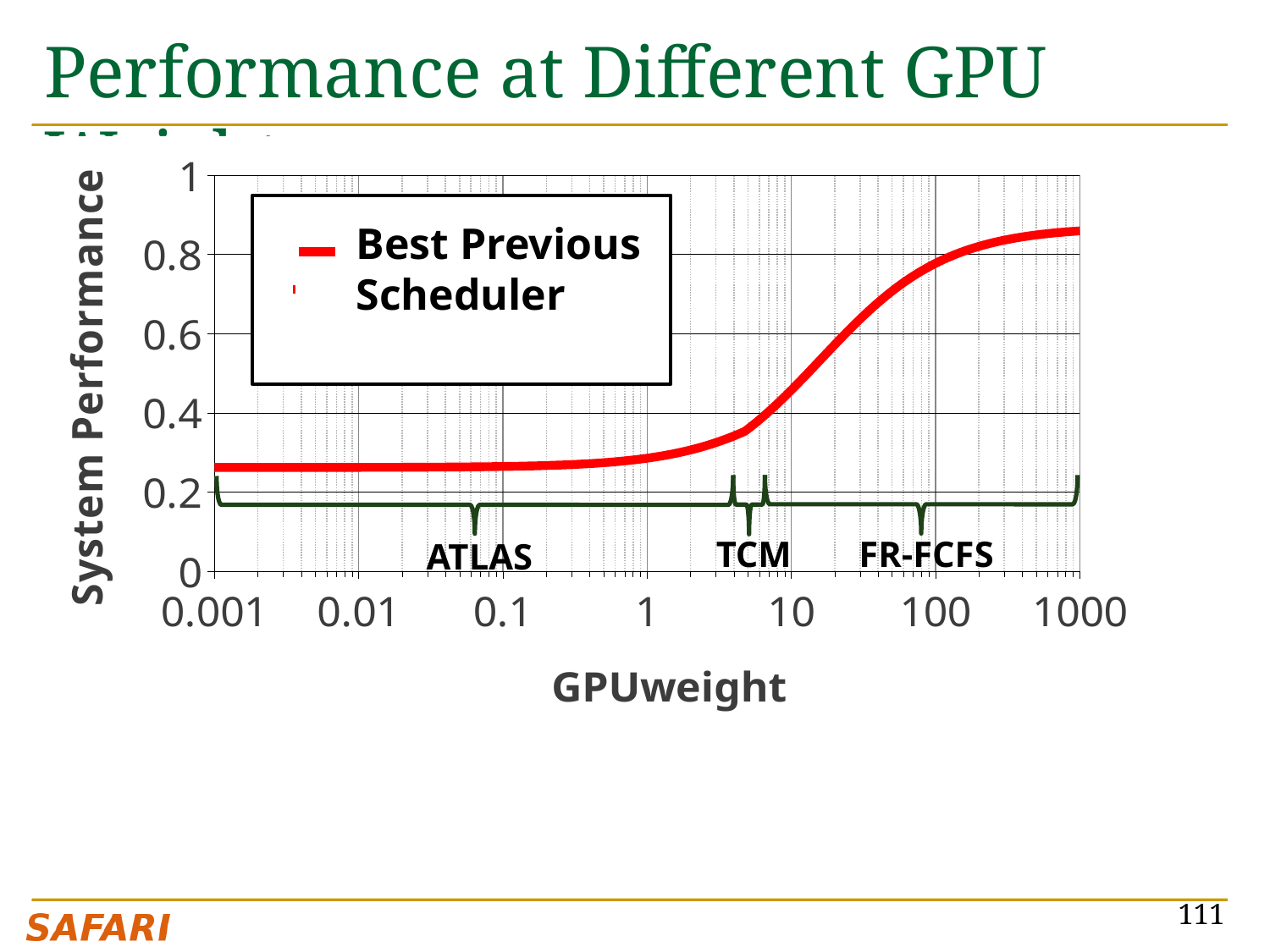
Is the System Performance of the Best Previous Scheduler at GPUweight 0.001 greater or less than 0.4? less What kind of chart is shown on the slide? line chart Is the System Performance of the Best Previous Scheduler at GPUweight 1 greater or less than 0.4? less Does the Best Previous Scheduler curve rise or fall as GPUweight increases from 0.001 to 1000? rise Is the System Performance of the Best Previous Scheduler at GPUweight 1000 greater or less than 1? less What is the label of the y axis? System Performance How many series are readable in the chart's legend? 1 Which scheduler name is bracketed over the highest GPUweight range on the chart? FR-FCFS Which is larger, the System Performance at GPUweight 1000 or at GPUweight 0.01? GPUweight 1000 What is the label of the x axis? GPUweight